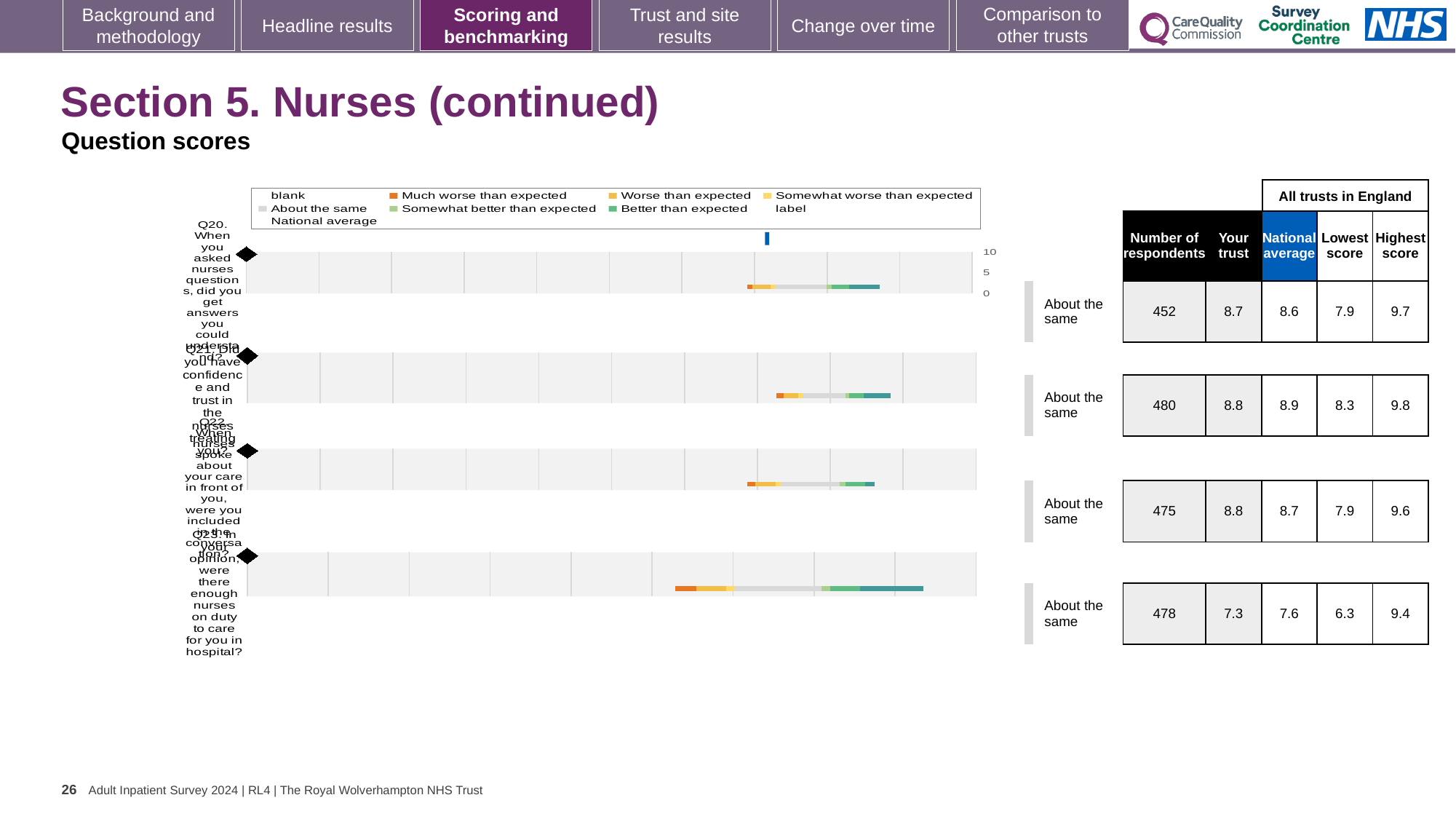
What colour represents 'Much worse than expected' in the legend? orange How many questions (Q20 to Q23) are charted on this slide? 4 What is the national average score for Q21 (confidence and trust in the nurses)? 8.9 How many respondents answered Q20 (did you get answers you could understand)? 452 What is the 'Your trust' score for Q23 (were there enough nurses on duty)? 7.3 What benchmark category is shown for Q23? About the same Which question has the lowest 'Your trust' score? Q23 For Q20, which is larger: the 'Your trust' score or the national average? Your trust Which question has the highest national average score? Q21 For Q23, what is the difference between the highest score (9.4) and the lowest score (6.3) across all trusts? 3.1 What is the highest score across all trusts in England for Q22? 9.6 What kind of chart is used for the question scores on this slide? bar chart